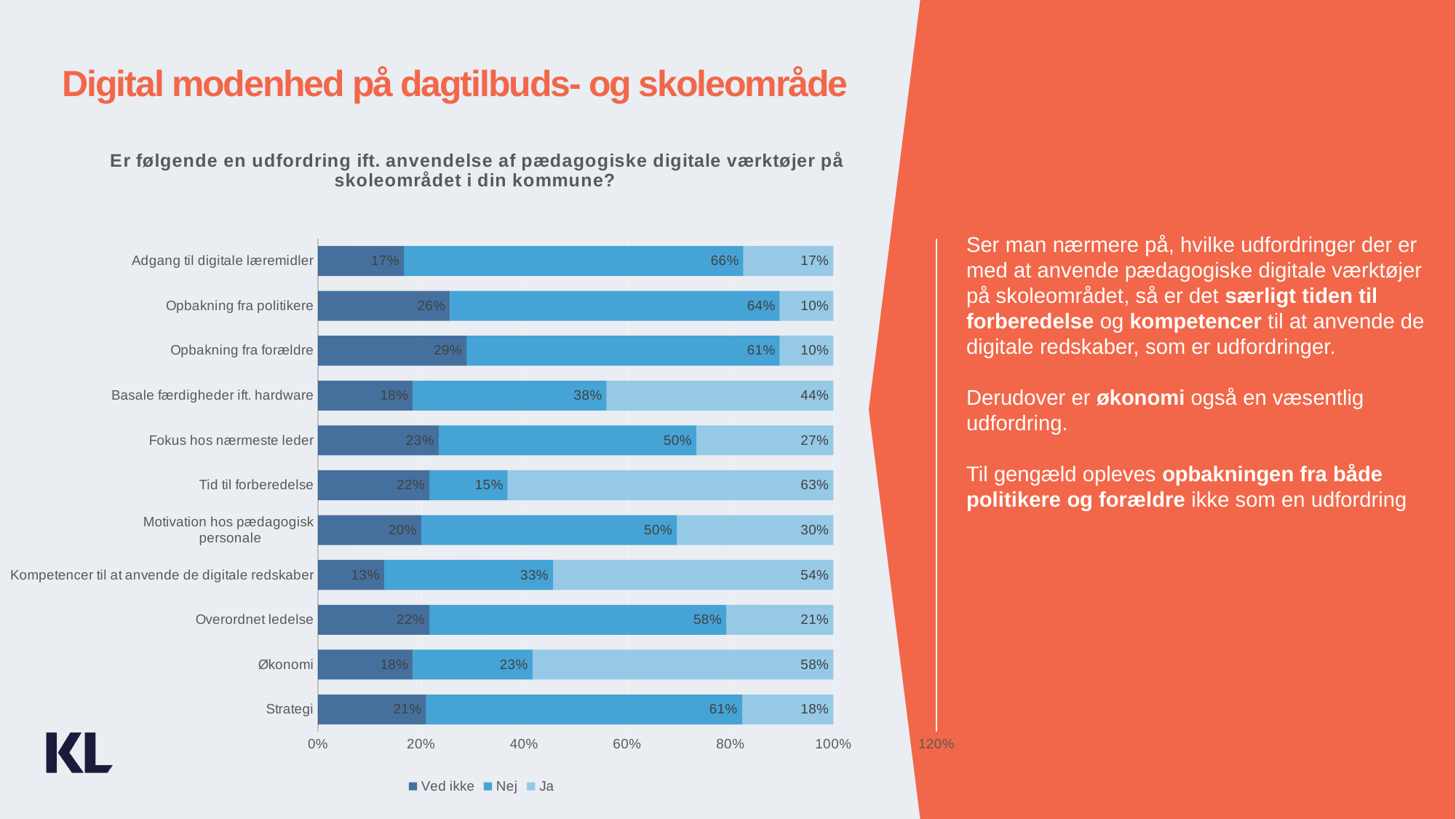
Which is larger: the 'Ja' value for 'Basale færdigheder ift. hardware' or the 'Ja' value for 'Fokus hos nærmeste leder'? Basale færdigheder ift. hardware How many categories are plotted on the chart? 11 Which category has the lowest 'Nej' value? Tid til forberedelse What type of chart is shown on the slide? Stacked bar chart Which category has the highest 'Ja' value? Tid til forberedelse What is the difference between the 'Ja' value for 'Tid til forberedelse' and the 'Ja' value for 'Økonomi'? 5 percentage points What are the three legend entries of the chart? Ved ikke, Nej, Ja Which category has the highest 'Nej' value? Adgang til digitale læremidler How many series does the legend list? 3 What is the 'Nej' value for 'Opbakning fra politikere'? 64% What is the 'Ved ikke' value for 'Kompetencer til at anvende de digitale redskaber'? 13% What is the 'Ja' value for 'Tid til forberedelse'? 63%